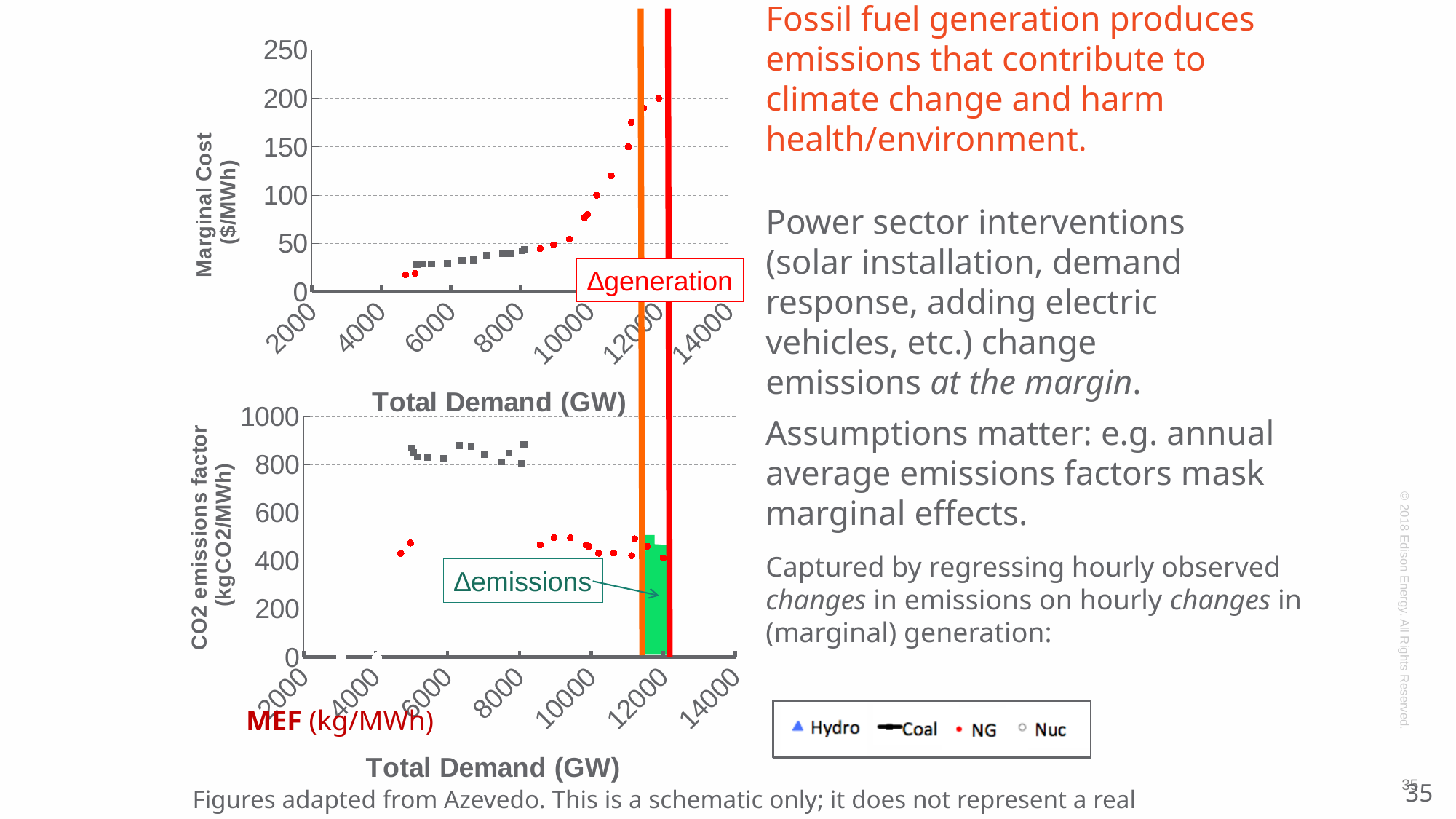
How many series does the legend at the bottom right of the slide list? 4 In the top chart, are the marginal cost values at a total demand of 6000 greater or less than 50? less In the bottom chart, are the Coal (grey square) emissions factor values greater or less than 600? greater In the top chart, do marginal cost values rise or fall as total demand increases along the x axis? rise What kind of chart is the bottom chart on the slide? scatter chart In the bottom chart, which series has the higher CO2 emissions factor values, Coal or NG? Coal In the top chart, is the highest plotted marginal cost value greater or less than 150? greater What is the y-axis label of the top chart? Marginal Cost ($/MWh) What kind of chart is the top chart on the slide? scatter chart How many charts are shown on the slide? 2 What is the x-axis label of the bottom chart? Total Demand (GW)